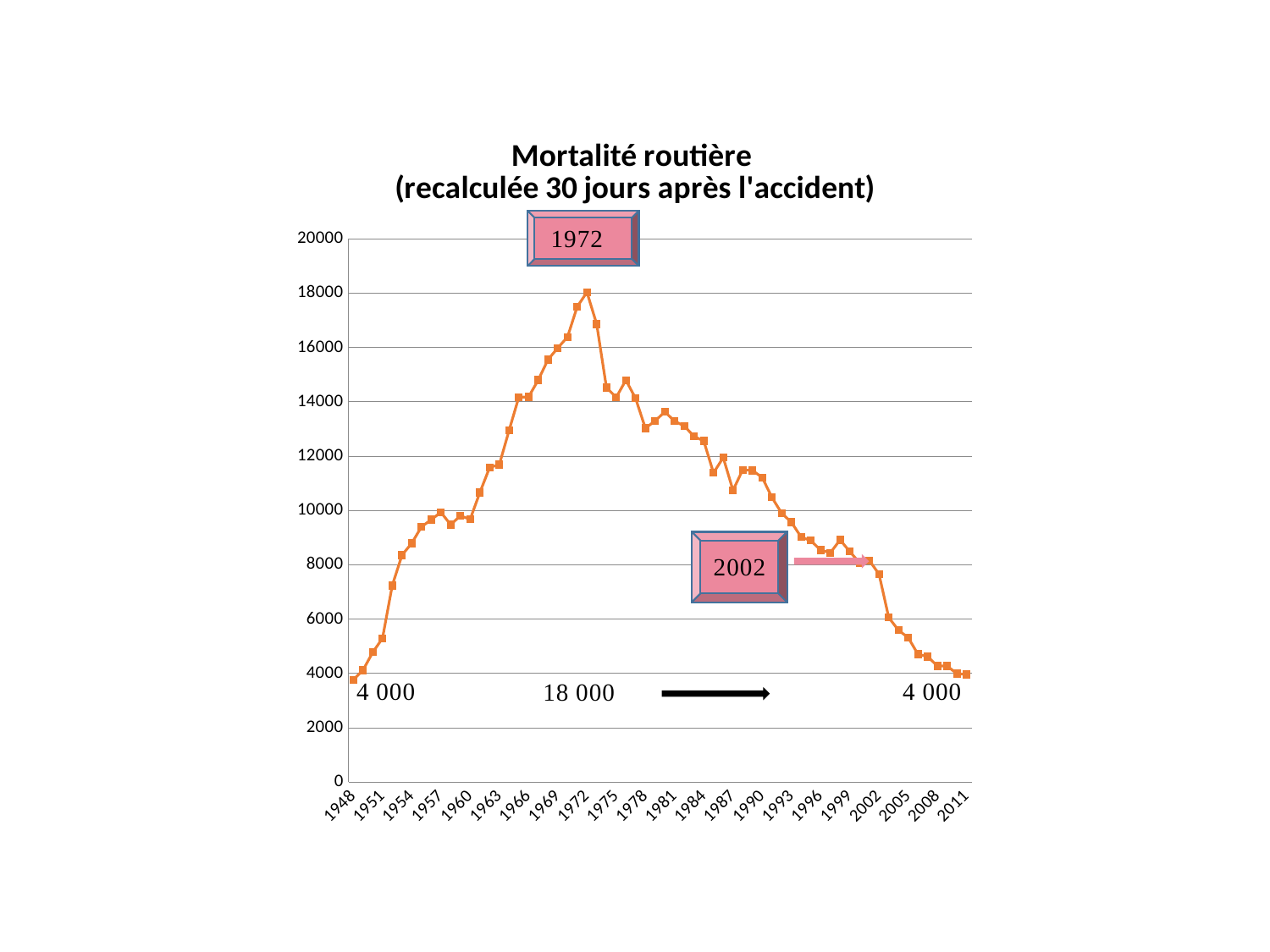
Do the values rise or fall along the x axis from 1972 to 2011? fall Is the value for 1990 greater or less than 10000? greater Is the value for 1948 greater or less than 6000? less Is the value for 2011 greater or less than 6000? less What kind of chart is shown on the slide? line chart Do the values rise or fall along the x axis from 1948 to 1972? rise What is the title of the chart? Mortalité routière (recalculée 30 jours après l'accident) Which year has the larger value, 1972 or 2002? 1972 In which year does the line reach its highest value? 1972 Which two years are highlighted in the labelled boxes on the chart? 1972 and 2002